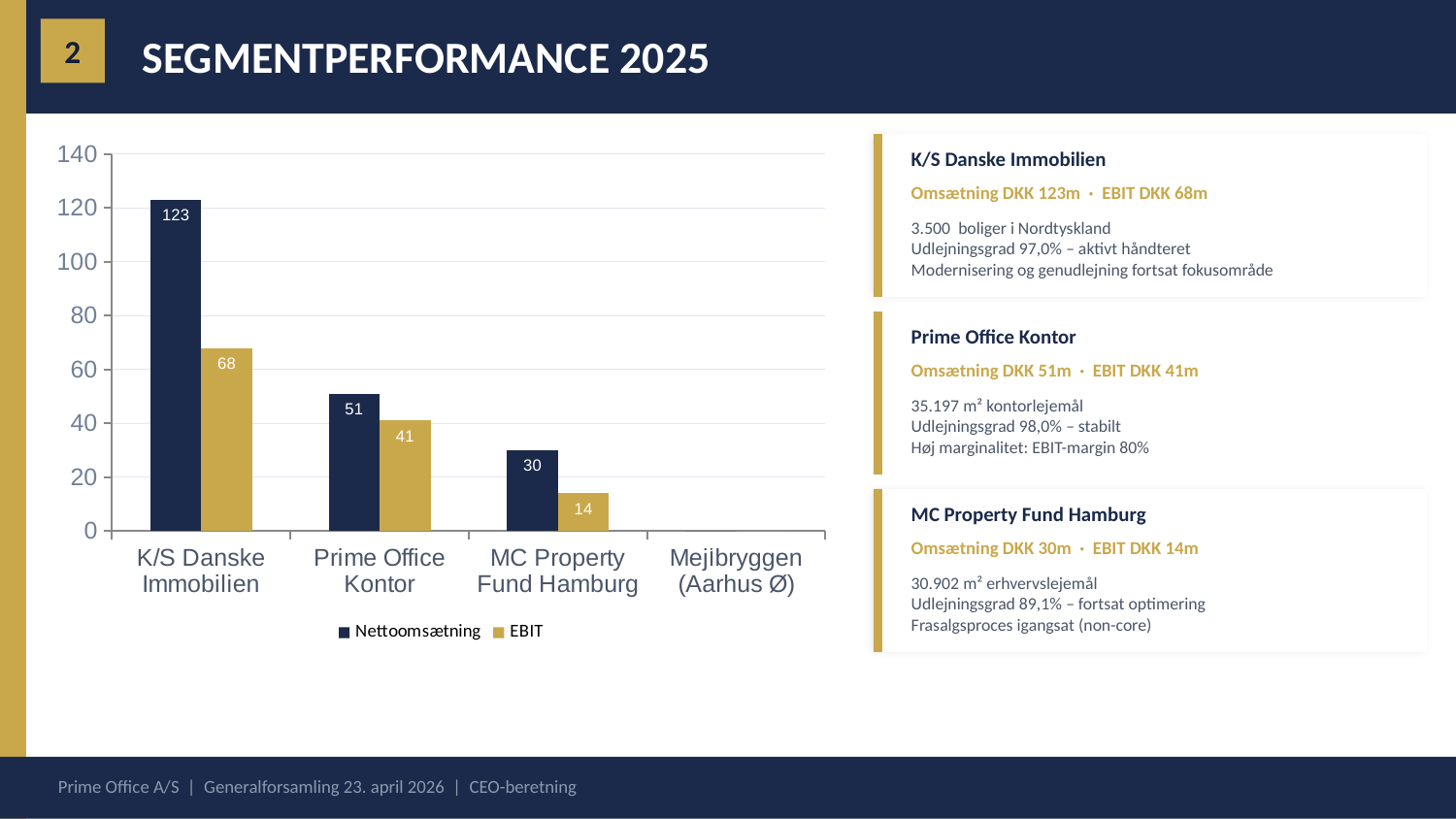
How many categories are shown on the x axis? 4 Which is larger: the EBIT of K/S Danske Immobilien or the Nettoomsætning of Prime Office Kontor? EBIT of K/S Danske Immobilien What is the difference between the Nettoomsætning of Prime Office Kontor and MC Property Fund Hamburg? 21 Among the categories with plotted bars, which has the lowest EBIT? MC Property Fund Hamburg What is the EBIT value for MC Property Fund Hamburg? 14 What is the difference between Nettoomsætning and EBIT for K/S Danske Immobilien? 55 How many series does the legend list? 2 Which category has the highest Nettoomsætning? K/S Danske Immobilien What is the Nettoomsætning value for K/S Danske Immobilien? 123 What kind of chart is shown on the slide? Bar chart Is the Nettoomsætning for K/S Danske Immobilien greater or less than 100? greater What is the EBIT value for Prime Office Kontor? 41